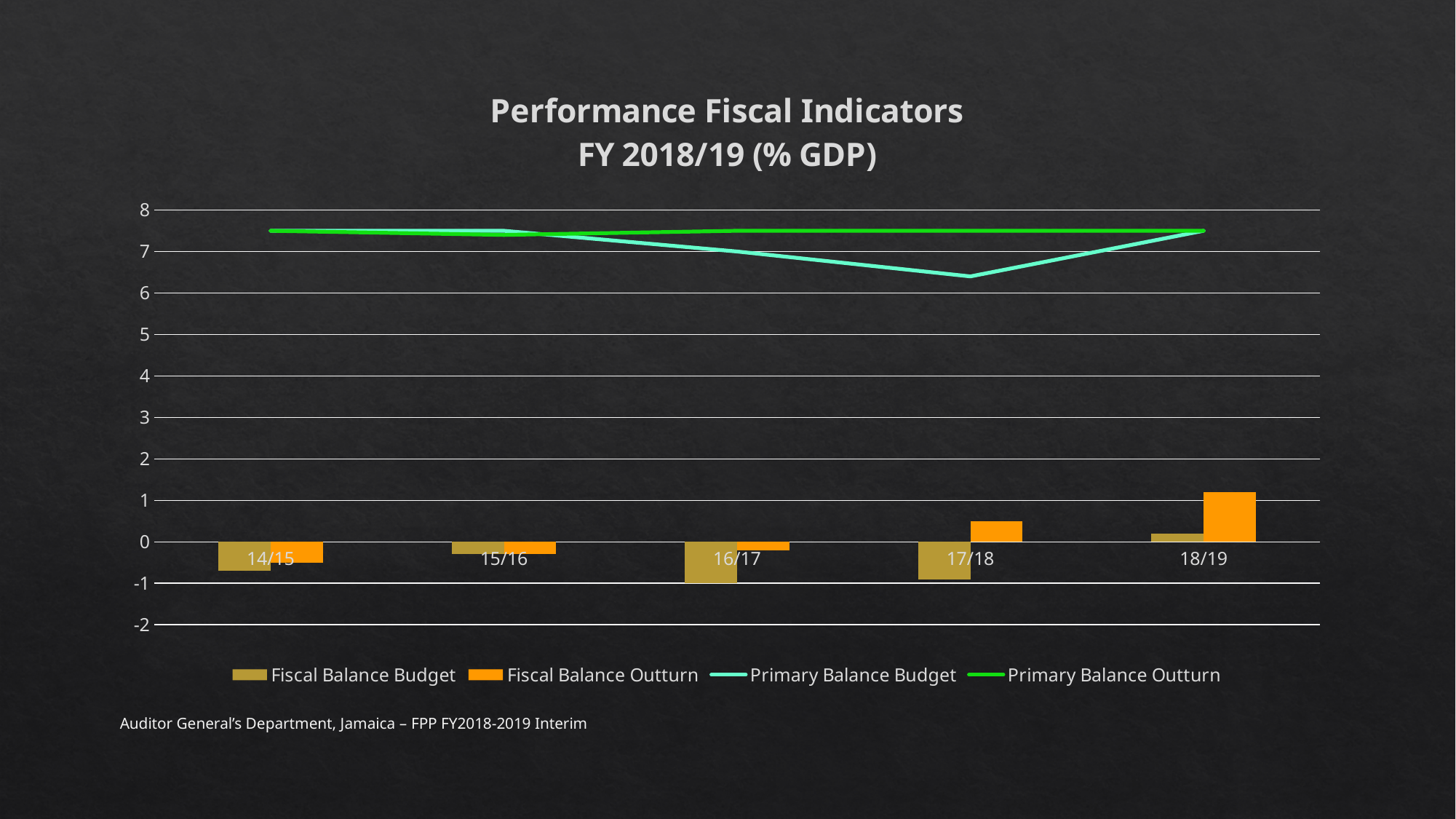
For 18/19, which is larger: Fiscal Balance Budget or Fiscal Balance Outturn? Fiscal Balance Outturn How many fiscal years are shown on the x axis? 5 Is the Fiscal Balance Outturn value for 18/19 greater or less than 1? greater What kind of chart is shown on the slide? A combined bar and line chart Is the Fiscal Balance Budget value for 16/17 greater or less than 0? less Is the Primary Balance Budget value for 17/18 greater or less than 7? less Which series is drawn in orange? Fiscal Balance Outturn How many series does the legend list? 4 In which fiscal year is Primary Balance Budget lowest? 17/18 In which fiscal year is Fiscal Balance Outturn highest? 18/19 What is the title of the chart? Performance Fiscal Indicators FY 2018/19 (% GDP) Does Fiscal Balance Outturn rise or fall from 14/15 to 18/19? rise